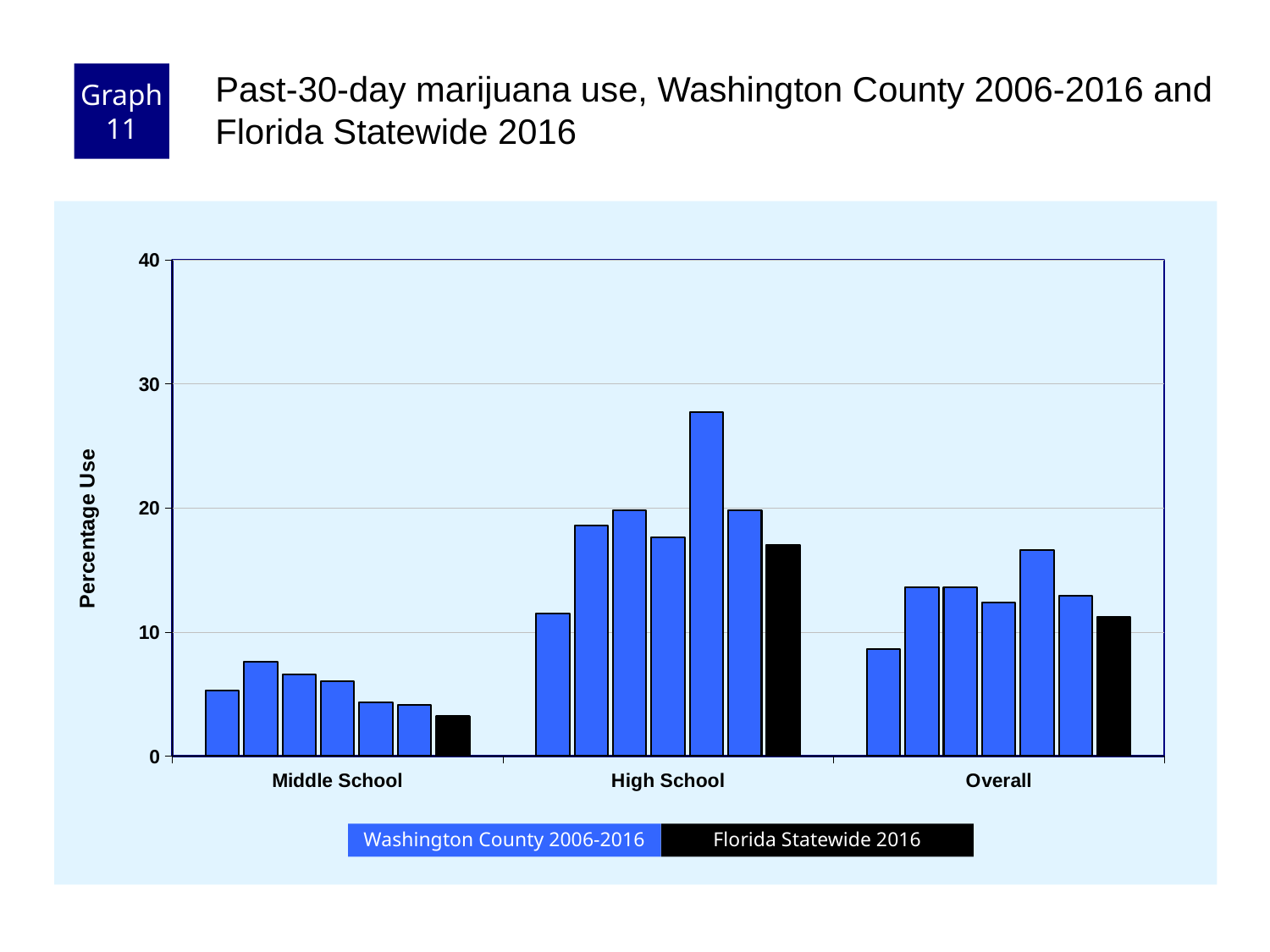
Is the Florida Statewide 2016 value for Middle School greater or less than 10? less How many categories are shown along the x axis? 3 Is the tallest Washington County bar in the High School group greater or less than 30? less Which category group contains the tallest bar in the chart? High School Is the Florida Statewide 2016 value for High School greater or less than 10? greater In which category group is the Florida Statewide 2016 bar the lowest? Middle School Which is larger: the Florida Statewide 2016 value for High School or for Middle School? High School What is the label on the y axis? Percentage Use What kind of chart is shown on the slide? bar chart How many series does the legend list? 2 What colour are the Florida Statewide 2016 bars? black